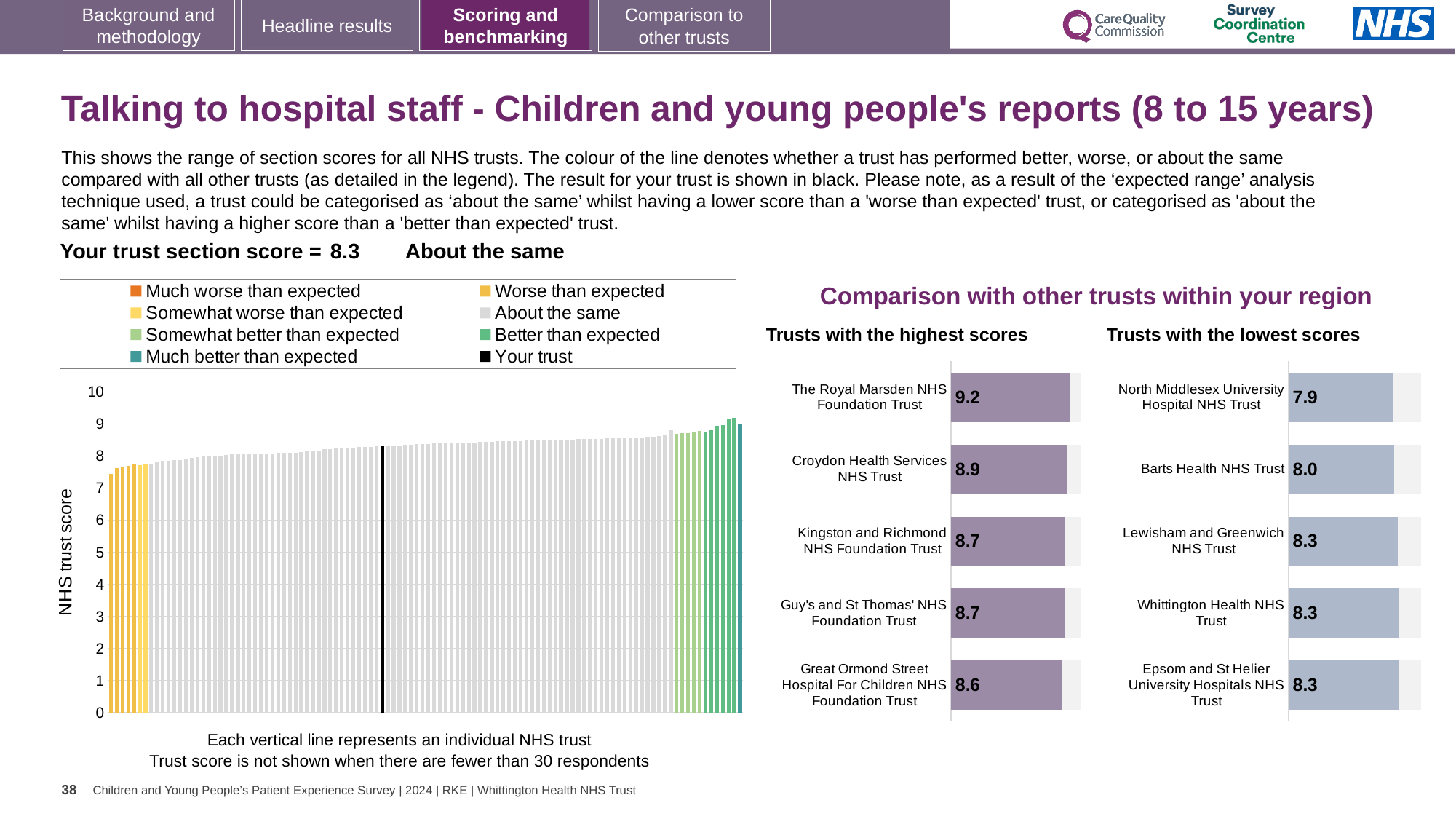
In the 'Trusts with the lowest scores' chart, which trust has the lowest score? North Middlesex University Hospital NHS Trust In the 'Trusts with the lowest scores' chart, what is the score for Barts Health NHS Trust? 8.0 What kind of chart is the large chart on the left showing NHS trust scores? Bar chart In the large chart on the left, how many entries does the legend list? 8 How many trusts are shown in the 'Trusts with the highest scores' chart? 5 In the 'Trusts with the highest scores' chart, what is the score for Croydon Health Services NHS Trust? 8.9 In the 'Trusts with the lowest scores' chart, which has the larger score: Barts Health NHS Trust or Lewisham and Greenwich NHS Trust? Lewisham and Greenwich NHS Trust In the 'Trusts with the highest scores' chart, what is the difference between the scores of The Royal Marsden NHS Foundation Trust and Great Ormond Street Hospital For Children NHS Foundation Trust? 0.6 In the 'Trusts with the highest scores' chart, what is the score for The Royal Marsden NHS Foundation Trust? 9.2 In the large chart on the left, do the trust scores rise or fall from left to right? Rise In the 'Trusts with the lowest scores' chart, what is the score for North Middlesex University Hospital NHS Trust? 7.9 In the 'Trusts with the highest scores' chart, which trust has the highest score? The Royal Marsden NHS Foundation Trust